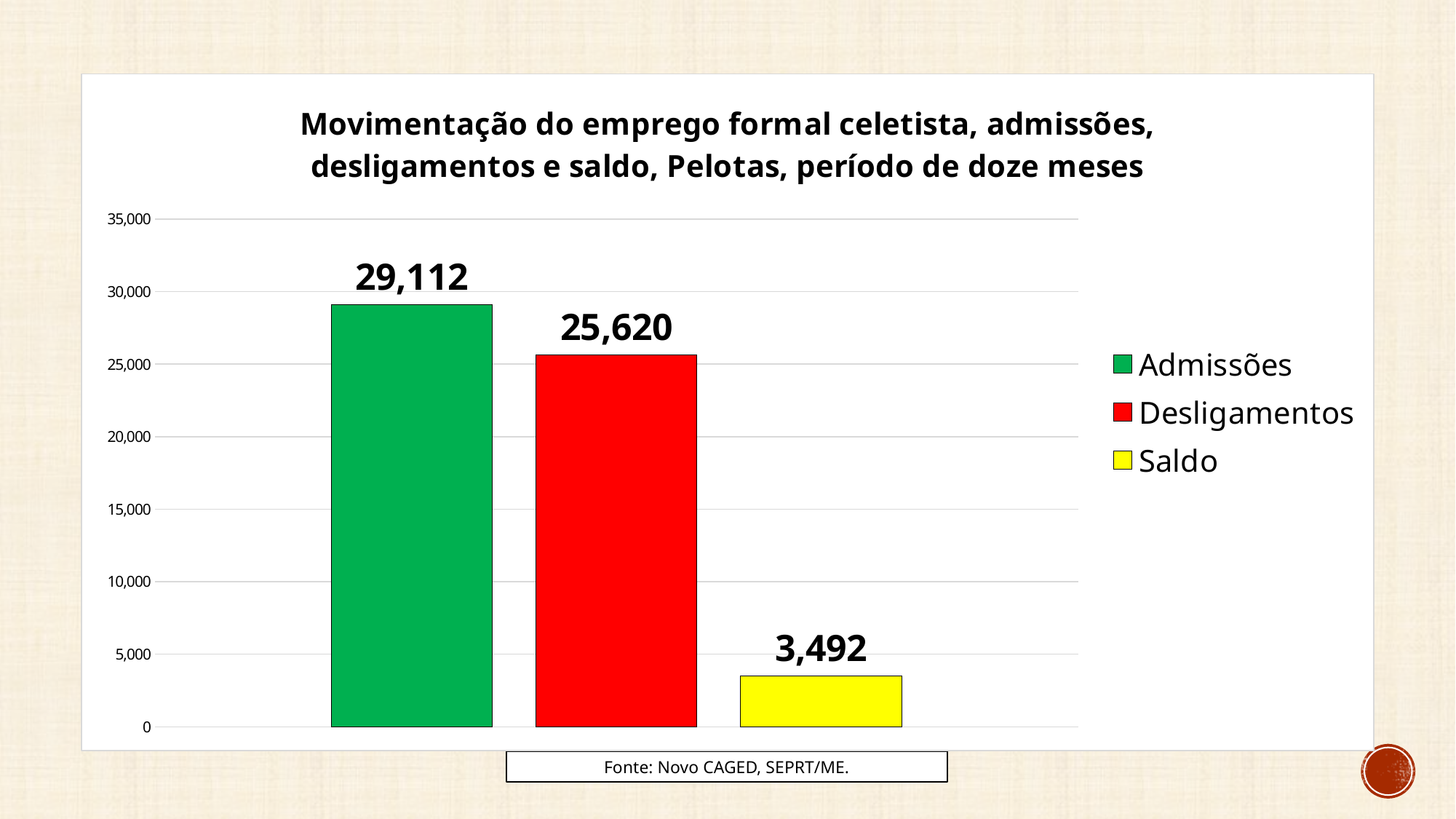
What colour is the bar for Saldo? yellow Is the value for Desligamentos greater or less than 25,000? greater Which series has the lowest value? Saldo Which is larger, Desligamentos or Saldo? Desligamentos What kind of chart is shown on the slide? bar chart What is the difference between Admissões and Desligamentos? 3,492 Which series has the highest value? Admissões How many series does the legend list? 3 How many bars are plotted in the chart? 3 What is the value for Saldo? 3,492 What is the value for Desligamentos? 25,620 What is the value for Admissões? 29,112